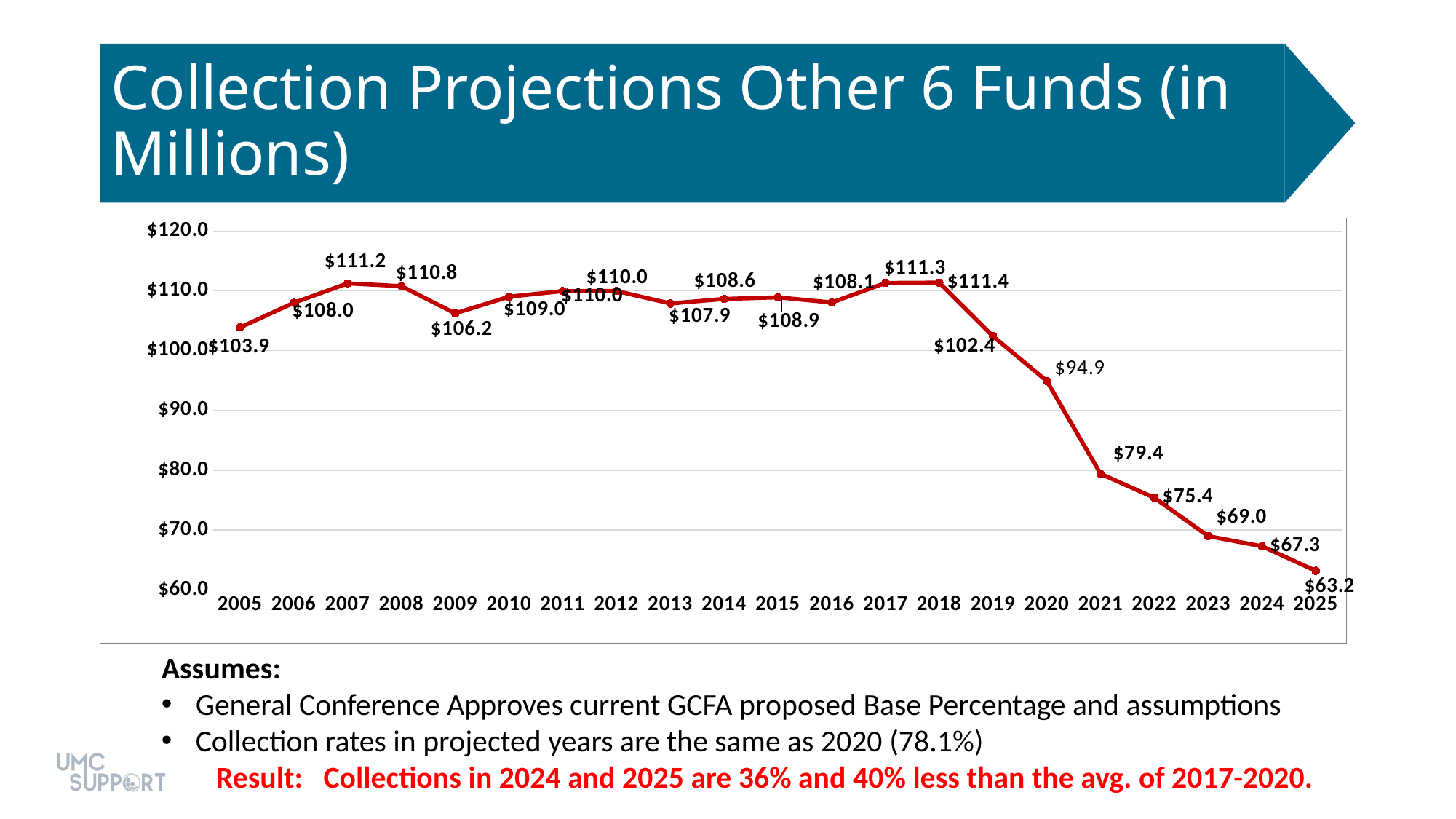
Which year has the lowest value? 2025 What is the value for 2020? $94.9 What is the difference between the values for 2018 and 2025? $48.2 Which is larger, the value for 2009 or the value for 2010? 2010 What is the value for 2025? $63.2 How many years are plotted on the chart? 21 What kind of chart is shown on the slide? line chart What is the value for 2005? $103.9 Do the values rise or fall from 2018 to 2025? fall Is the value for 2021 greater or less than $80.0? less What is the difference between the values for 2020 and 2021? $15.5 What is the value for 2007? $111.2